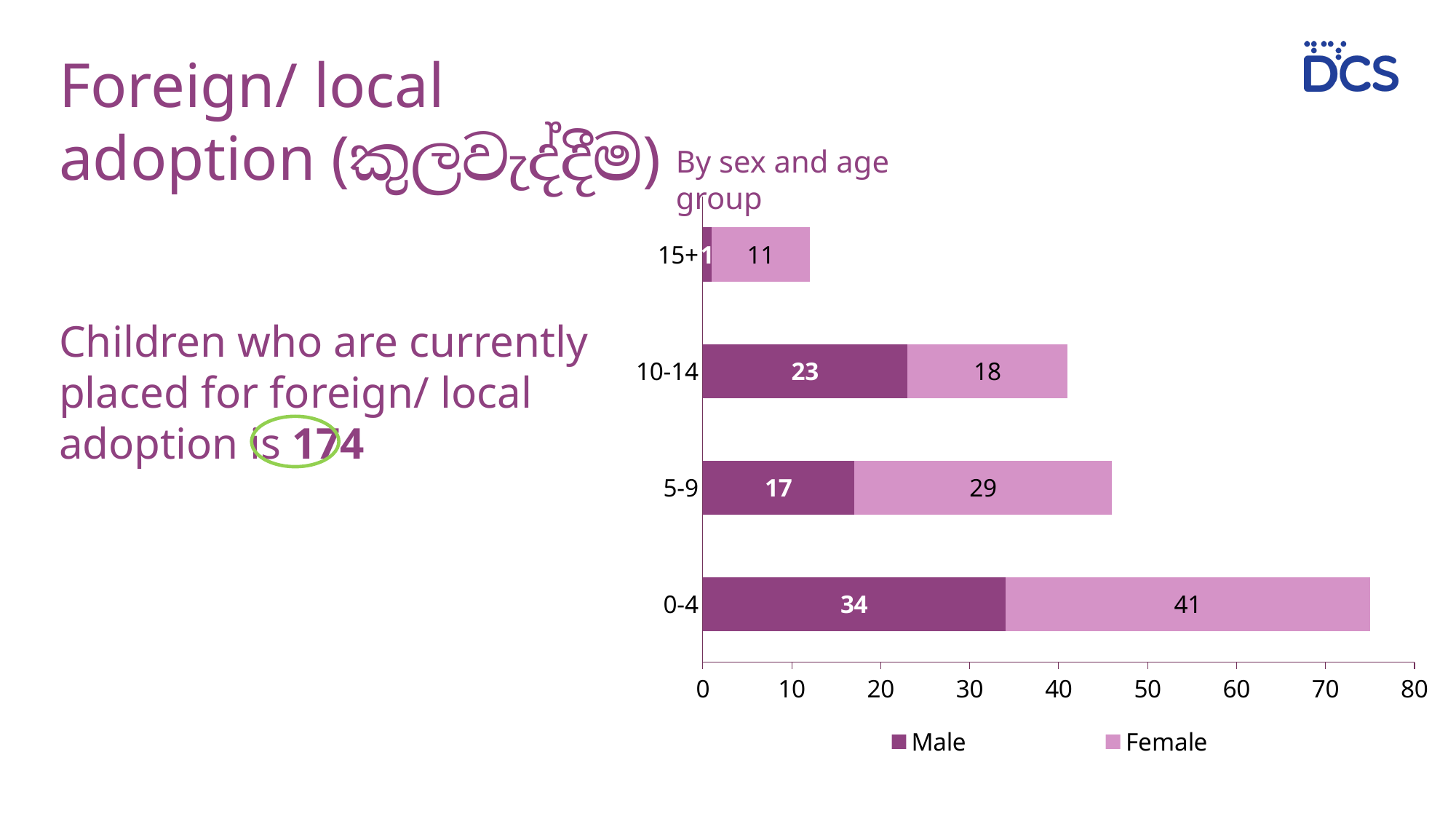
What is the Female value for the 15+ age group? 11 What is the total of the stacked bar for the 10-14 age group? 41 What is the Female value for the 5-9 age group? 29 Which age group has the highest Female value? 0-4 Which age group has the lowest Male value? 15+ What is the Male value for the 0-4 age group? 34 Which is larger for the 10-14 age group, the Male value or the Female value? Male How many series does the legend list? 2 How many age groups are shown on the chart? 4 What is the difference between the Female and Male values for the 5-9 age group? 12 What is the total of the stacked bar for the 0-4 age group? 75 What kind of chart is shown on the slide? Stacked bar chart